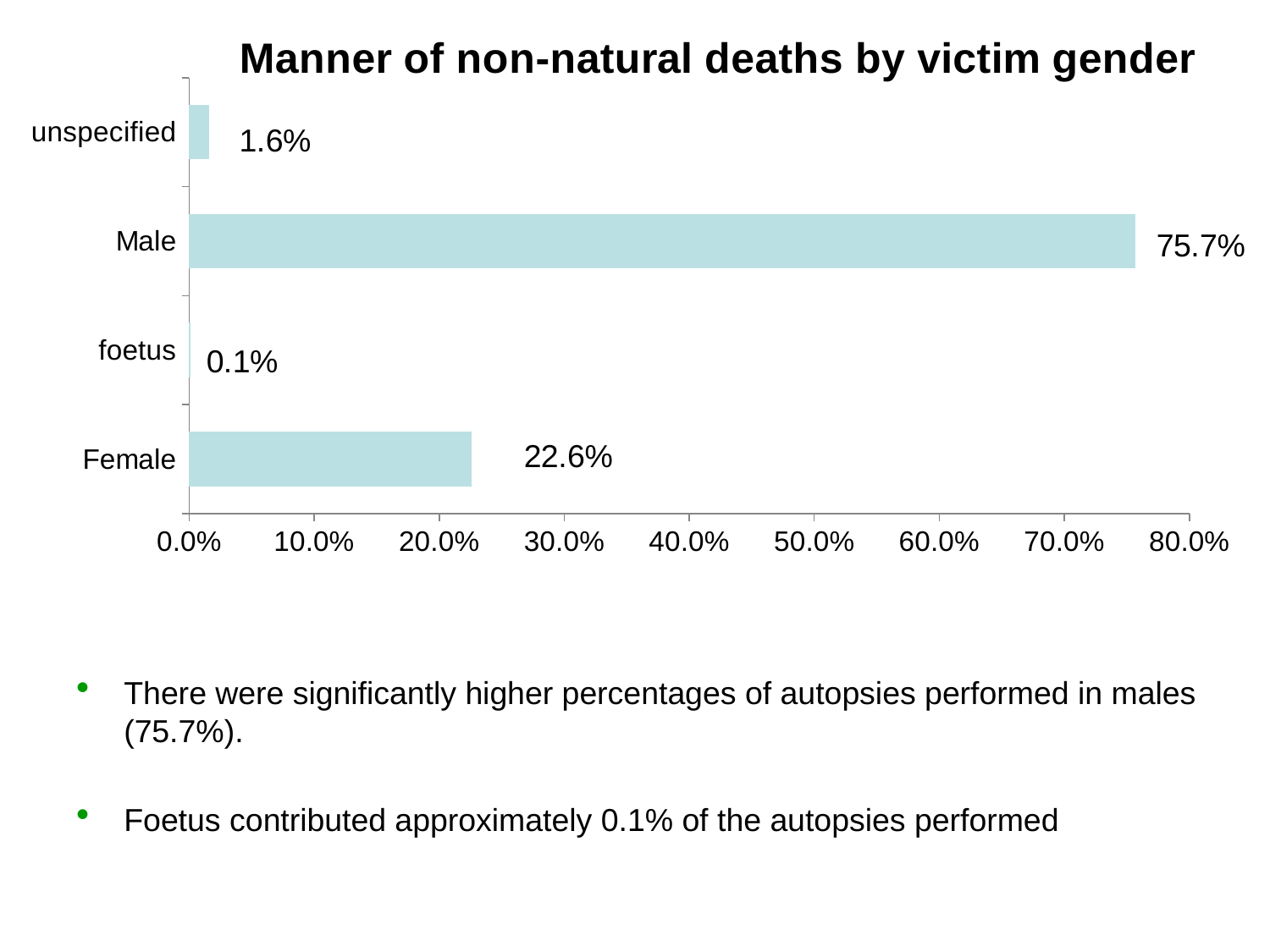
What is the value for unspecified? 1.6% What is the difference between the values for Male and Female? 53.1% What is the title of the chart? Manner of non-natural deaths by victim gender What is the value for Male? 75.7% Which is larger, the value for Female or the value for unspecified? Female Which category has the highest value? Male What is the value for Female? 22.6% How many categories are shown in the chart? 4 Is the value for Male greater or less than 70.0%? greater Which category has the lowest value? foetus What is the value for foetus? 0.1% What kind of chart is shown on the slide? bar chart